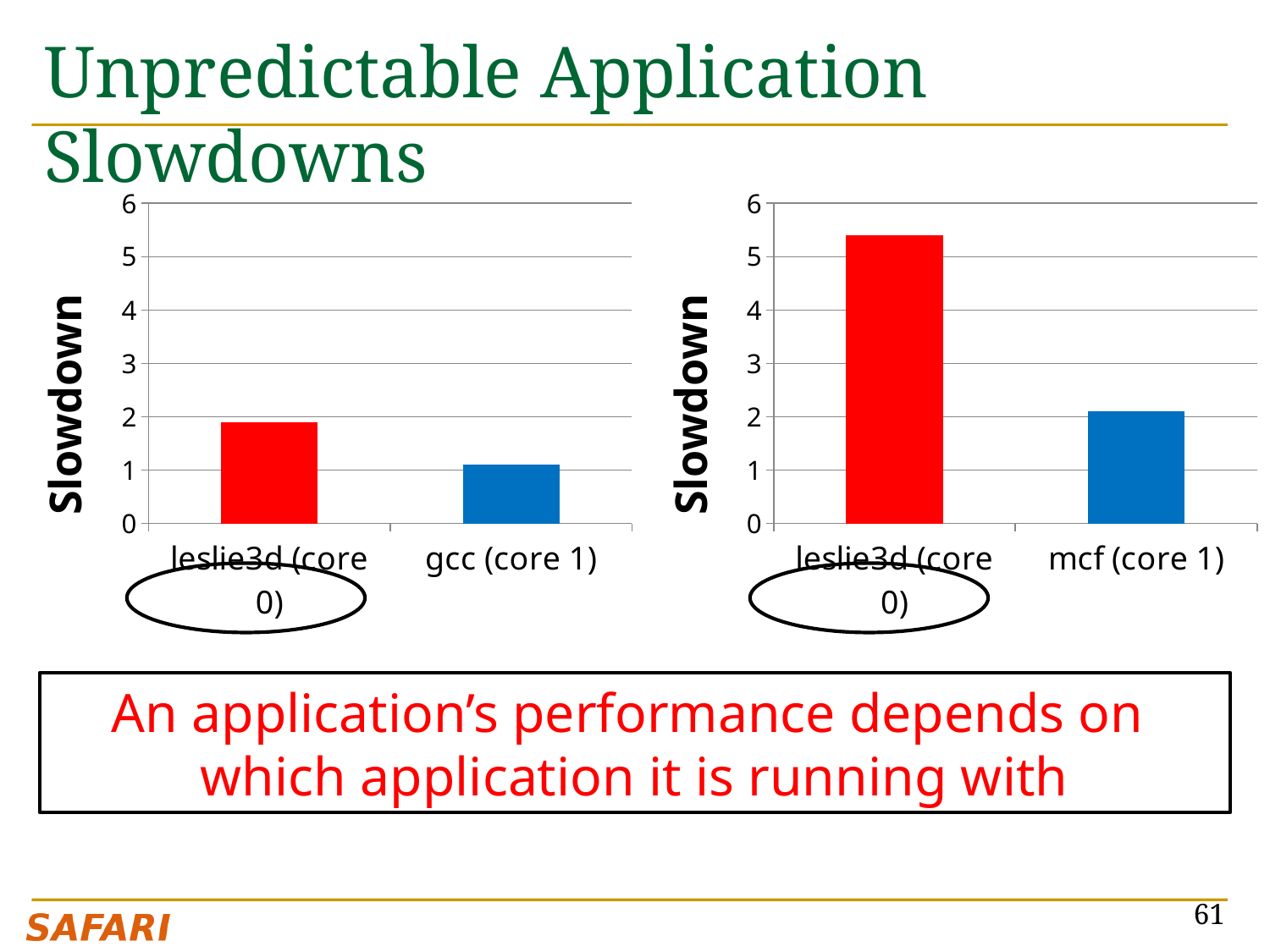
In the right chart, is the slowdown for leslie3d (core 0) greater or less than 5? greater Is the slowdown of leslie3d (core 0) larger in the left chart or in the right chart? right chart In the left chart, which category has the higher slowdown? leslie3d (core 0) What kind of chart is the left chart on the slide? bar chart In the right chart, which category has the lower slowdown? mcf (core 1) What is the label of the y axis on the left chart? Slowdown In the left chart, is the slowdown for gcc (core 1) greater or less than 2? less How many categories are shown in the right chart? 2 In the right chart, what colour is the bar for leslie3d (core 0)? red In the right chart, is the slowdown for mcf (core 1) greater or less than 1? greater